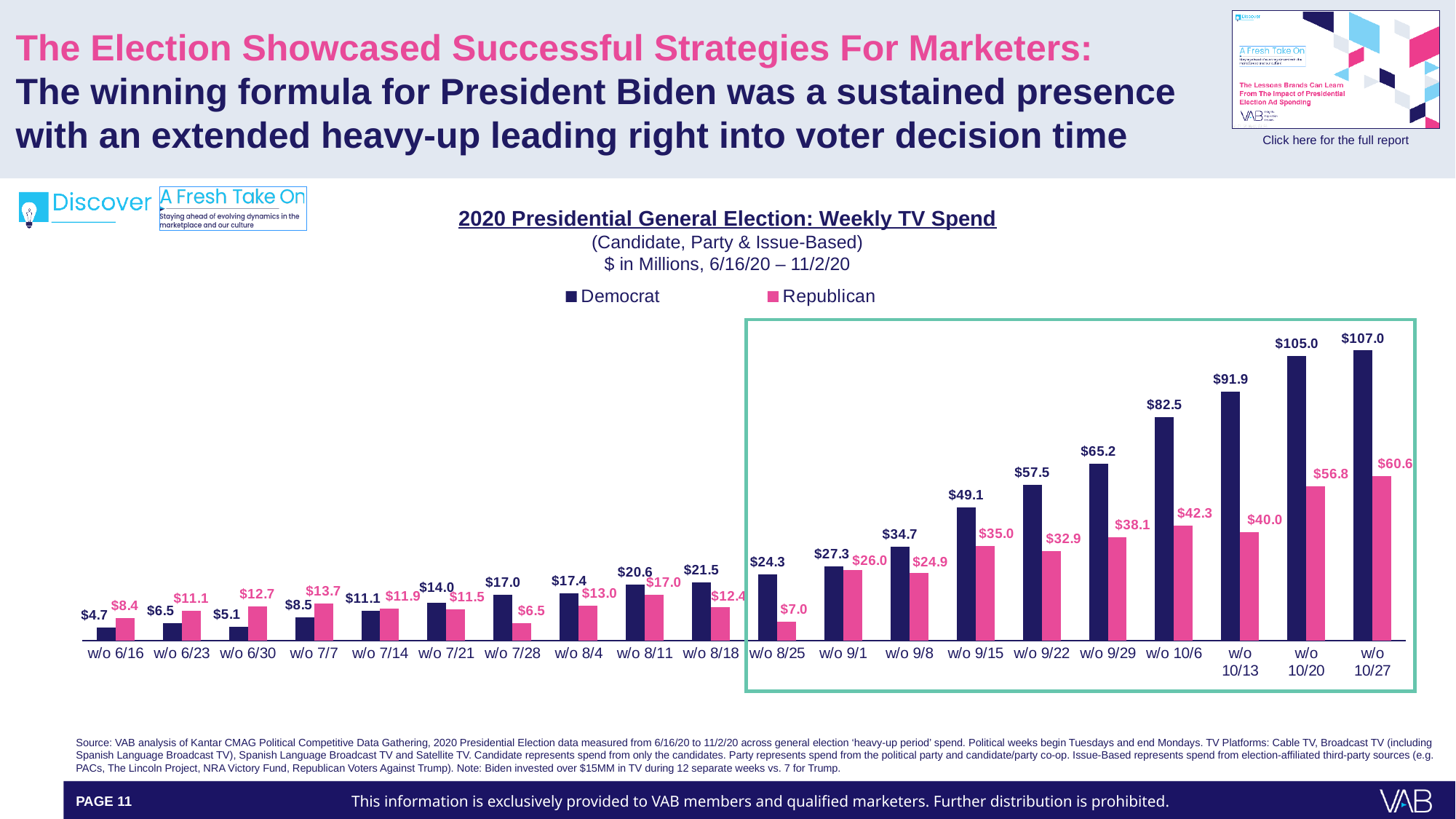
In w/o 6/23, which party had the higher TV spend? Republican How many weeks are shown on the x axis of the chart? 20 In which week was Democrat TV spend the highest? w/o 10/27 What was the Democrat weekly TV spend for w/o 10/27? $107.0 How many series does the legend list? 2 What was the Republican weekly TV spend for w/o 8/25? $7.0 In which week was Republican TV spend the lowest? w/o 7/28 How much more did Democrats spend than Republicans in w/o 10/27? $46.4 Does Democrat weekly TV spend generally rise or fall from w/o 6/16 to w/o 10/27? Rise What is the combined Democrat and Republican TV spend for w/o 9/1? $53.3 What kind of chart is used to show the weekly TV spend? Bar chart In which week was Democrat TV spend the lowest? w/o 6/16